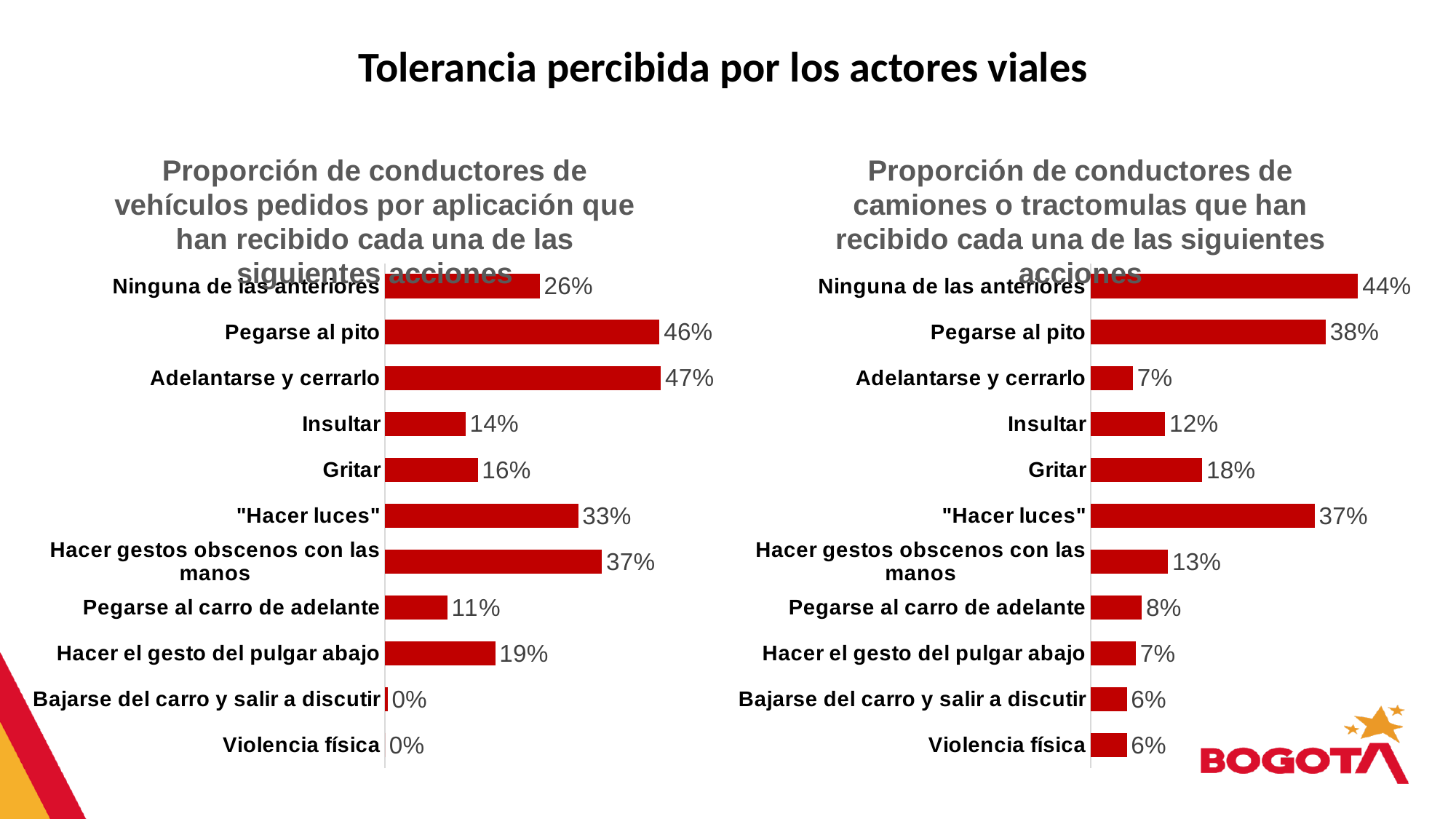
How many categories are shown in the left chart (conductores de vehículos pedidos por aplicación)? 11 What type of chart is used on the right side of the slide (conductores de camiones o tractomulas)? Bar chart In the left chart (conductores de vehículos pedidos por aplicación), what value is shown for "Bajarse del carro y salir a discutir"? 0% In the left chart (conductores de vehículos pedidos por aplicación), what percentage is shown for "Pegarse al pito"? 46% In the left chart (conductores de vehículos pedidos por aplicación), which is larger: "Hacer luces" or "Hacer gestos obscenos con las manos"? Hacer gestos obscenos con las manos In the right chart (conductores de camiones o tractomulas), what is the value for "Violencia física"? 6% What is the main title of the slide? Tolerancia percibida por los actores viales In the right chart (conductores de camiones o tractomulas), what percentage is shown for "Hacer luces"? 37% In the right chart (conductores de camiones o tractomulas), what is the difference between "Pegarse al pito" and "Adelantarse y cerrarlo"? 31% In the left chart (conductores de vehículos pedidos por aplicación), which category has the highest value? Adelantarse y cerrarlo In the left chart (conductores de vehículos pedidos por aplicación), what is the difference between "Adelantarse y cerrarlo" and "Insultar"? 33% In the right chart (conductores de camiones o tractomulas), which category has the highest value? Ninguna de las anteriores